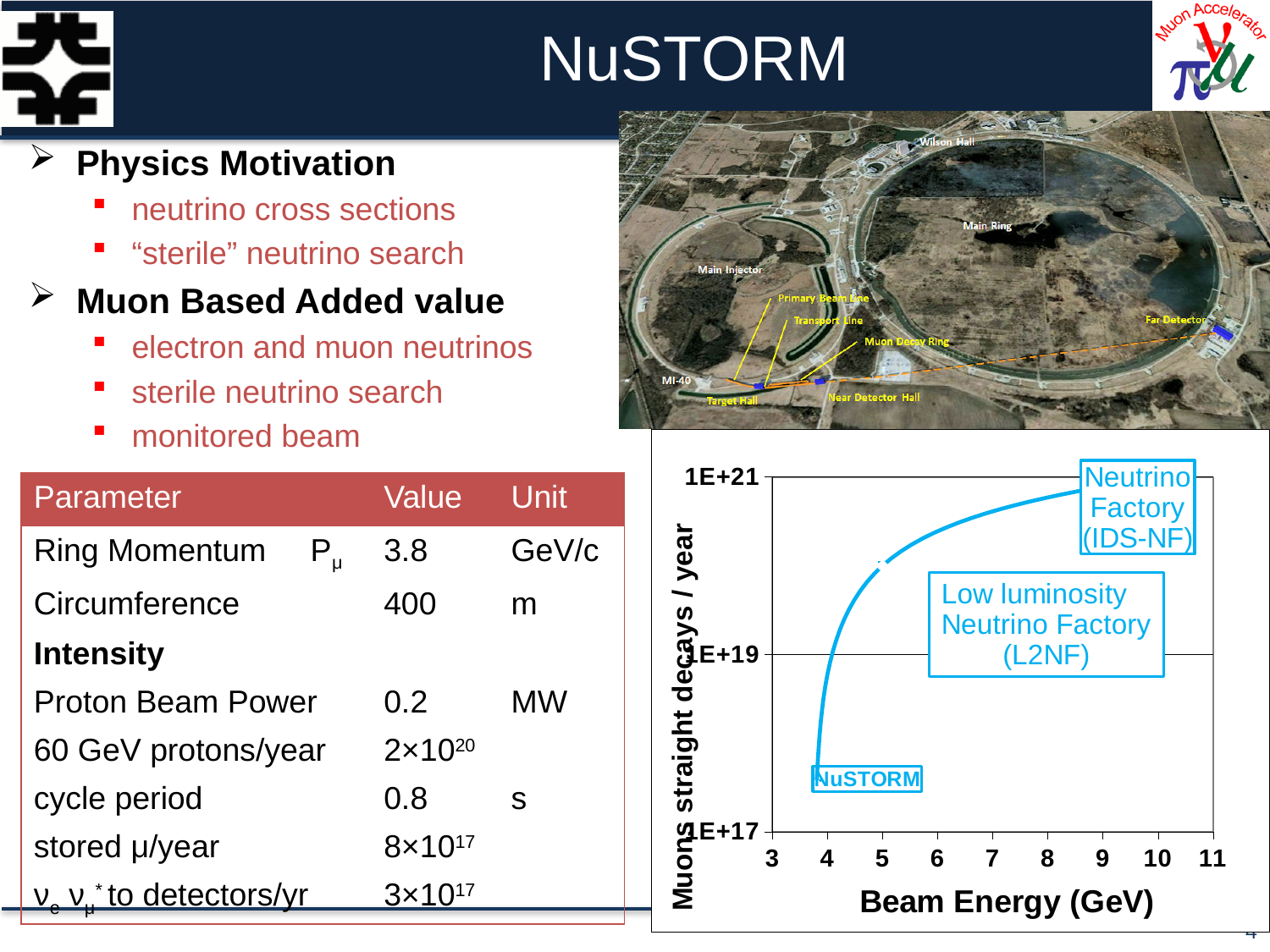
What is the highest tick value shown on the y axis of the chart? 1E+21 Do the muon decays per year rise or fall as beam energy increases along the x axis? rise Which labelled point on the chart has the lowest muon decays per year? NuSTORM What is the title of the x axis of the chart? Beam Energy (GeV) Which has more muon decays per year, NuSTORM or the Low luminosity Neutrino Factory (L2NF)? Low luminosity Neutrino Factory (L2NF) Which labelled facility on the chart has the highest muon decays per year? Neutrino Factory (IDS-NF) Is the value of the curve at a beam energy of 5 GeV greater or less than 1E+19? greater How many tick labels are shown on the x axis of the chart? 9 What kind of chart is shown at the bottom right of the slide? line chart Is the value of the curve at a beam energy of 8 GeV greater or less than 1E+19? greater What is the title of the y axis of the chart? Muons straight decays / year